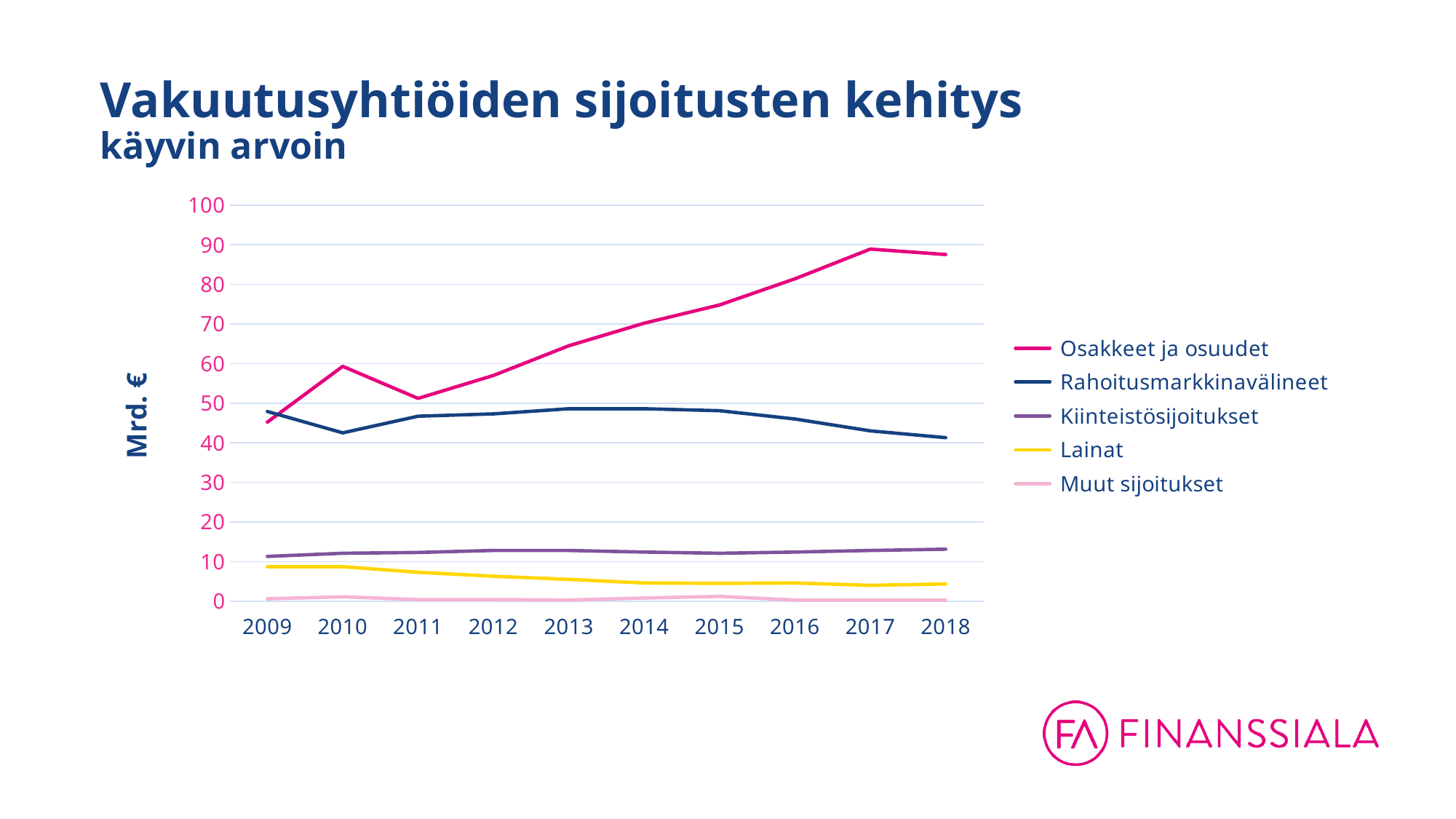
In 2010, which is larger: Osakkeet ja osuudet or Rahoitusmarkkinavälineet? Osakkeet ja osuudet Is the value for Rahoitusmarkkinavälineet in 2018 greater or less than 50? less What is the label on the y axis? Mrd. € In which year does Osakkeet ja osuudet reach its highest value? 2017 Does the value for Lainat rise or fall from 2009 to 2018? fall In which year is Osakkeet ja osuudet at its lowest value? 2009 How many series does the legend list? 5 Is the value for Osakkeet ja osuudet in 2017 greater or less than 80? greater Which series has the lowest value in 2018? Muut sijoitukset How many years are shown on the x axis? 10 Which series has the highest value in 2018? Osakkeet ja osuudet What kind of chart is shown on the slide? line chart